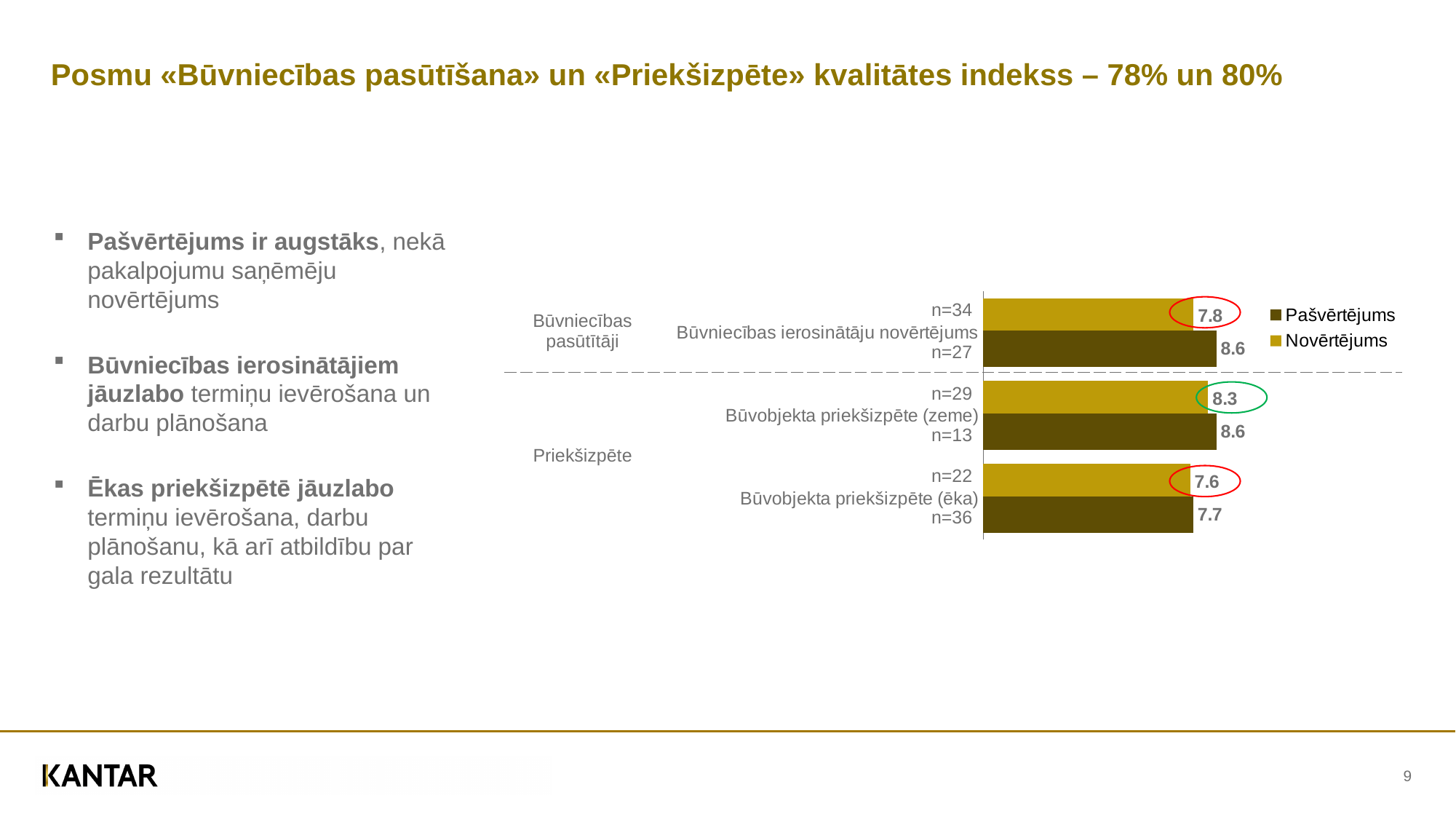
How many series does the legend list? 2 What is the Pašvērtējums value for Būvniecības ierosinātāju novērtējums? 8.6 What kind of chart is shown on the slide? Bar chart What is the Novērtējums value for Būvobjekta priekšizpēte (zeme)? 8.3 Which category has the highest Novērtējums value? Būvobjekta priekšizpēte (zeme) Which category has the lowest Novērtējums value? Būvobjekta priekšizpēte (ēka) What is the difference between the Pašvērtējums and Novērtējums values for Būvniecības ierosinātāju novērtējums? 0.8 What is the Novērtējums value for Būvniecības ierosinātāju novērtējums? 7.8 How many categories are shown in the chart? 3 For Būvobjekta priekšizpēte (ēka), which is larger: Pašvērtējums or Novērtējums? Pašvērtējums What is the Pašvērtējums value for Būvobjekta priekšizpēte (ēka)? 7.7 What is the difference between the Pašvērtējums and Novērtējums values for Būvobjekta priekšizpēte (zeme)? 0.3